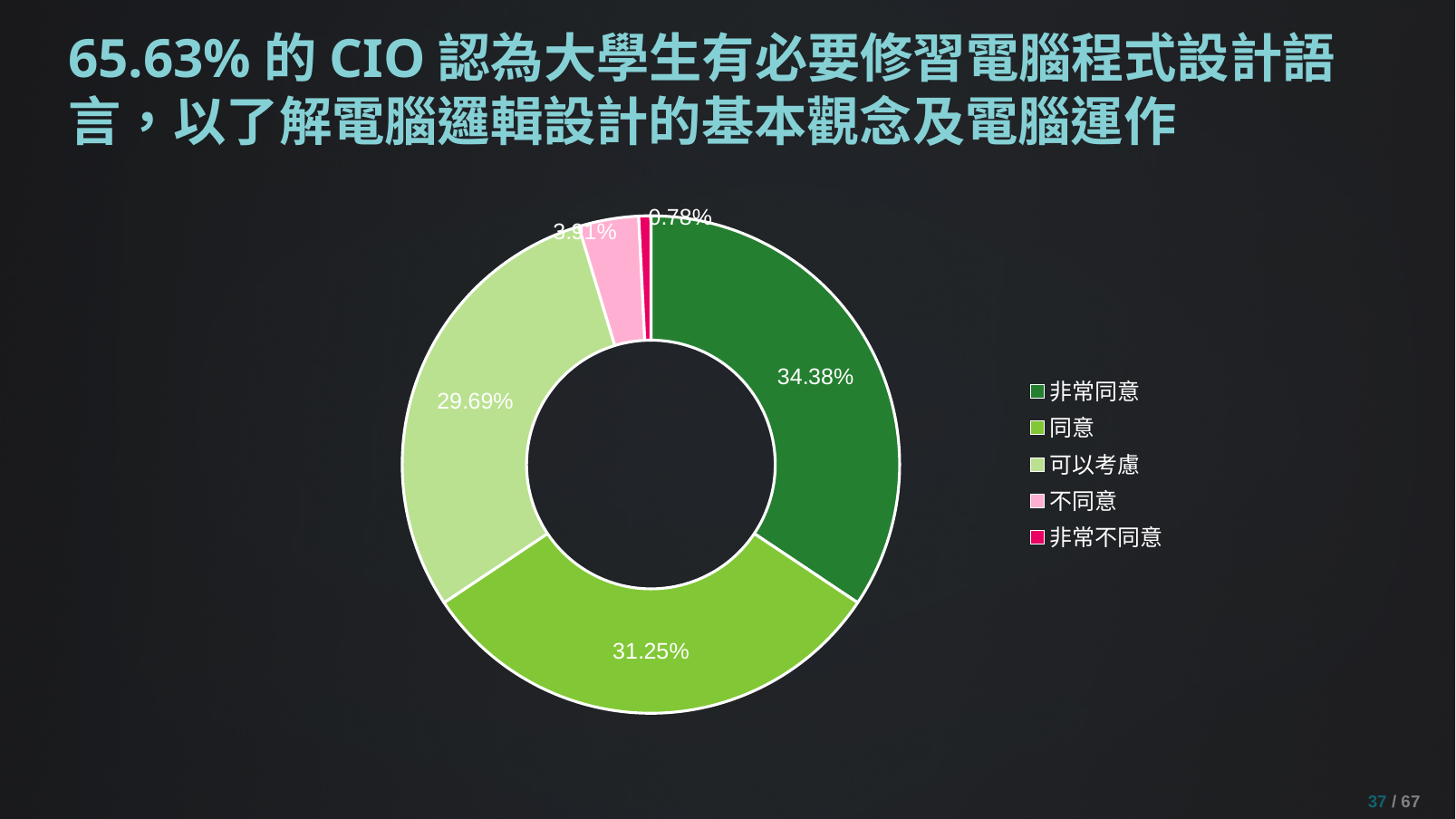
What is the value for 不同意? 3.91% What percentage is labelled for 可以考慮? 29.69% What colour is the 非常不同意 slice in the legend? dark pink / magenta What share of the pie does 非常同意 represent? 34.38% How many categories does the chart show? 5 Which is larger, the 可以考慮 slice or the 不同意 slice? 可以考慮 What is the value for 非常不同意? 0.78% What kind of chart is shown on the slide? doughnut (pie) chart What is the value shown for 同意? 31.25% What is the difference between the 非常同意 and 同意 slices? 3.13% Which category has the largest slice? 非常同意 Which category has the smallest slice? 非常不同意